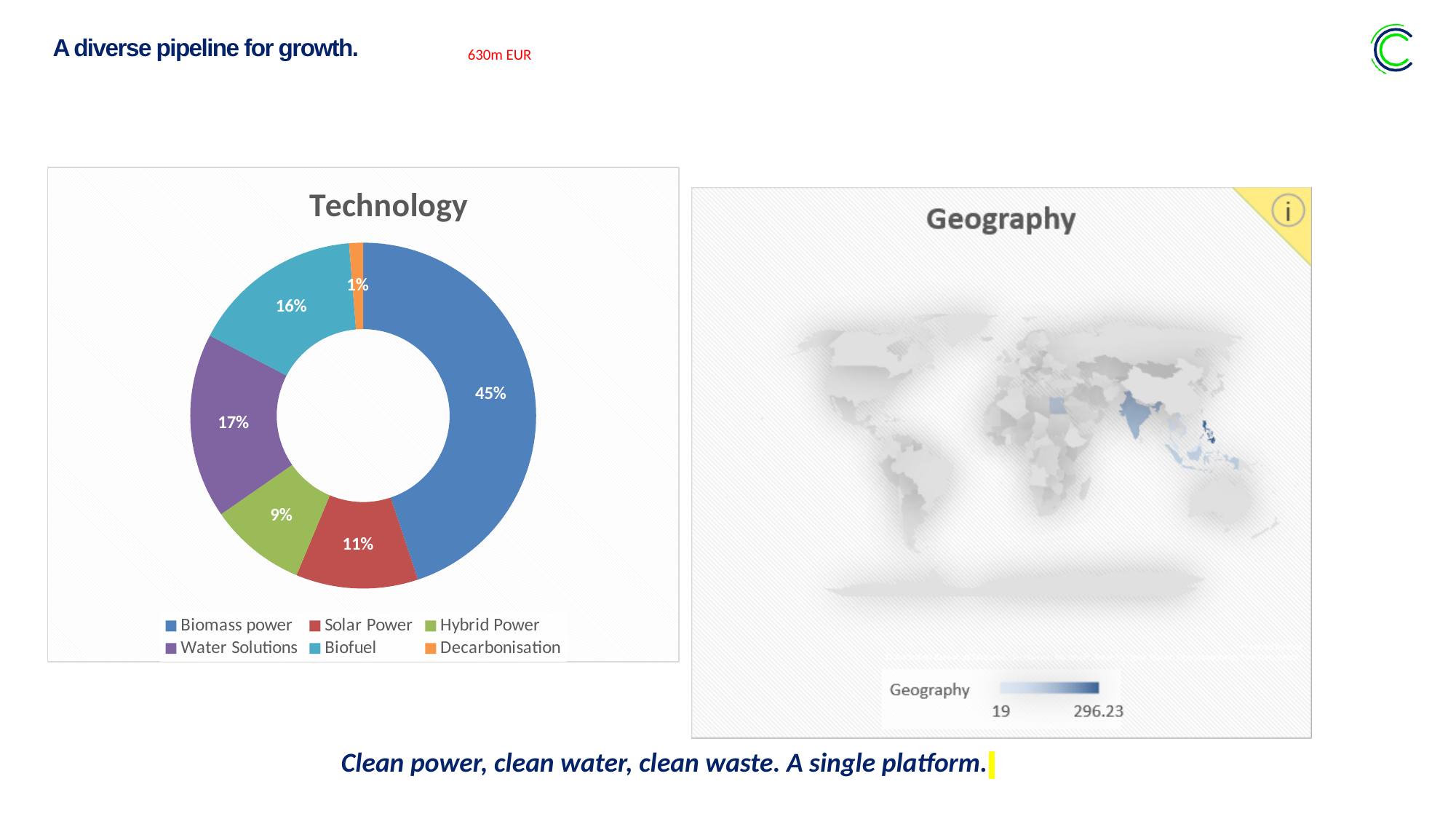
In the Geography chart, what are the minimum and maximum values shown on the colour scale? 19 and 296.23 In the Technology chart, which category has the smallest share? Decarbonisation In the Technology chart, what share does Water Solutions have? 17% What kind of chart is the Technology chart? Doughnut chart How many categories does the Technology chart show? 6 In the Technology chart, what share does Solar Power have? 11% In the Technology chart, what share does Biomass power have? 45% What kind of chart is the Geography chart? Map chart In the Technology chart, what is the difference in percentage points between Biomass power and Solar Power? 34 In the Technology chart, what share does Biofuel have? 16% In the Technology chart, which is larger, Hybrid Power or Biofuel? Biofuel In the Technology chart, which category has the largest share? Biomass power